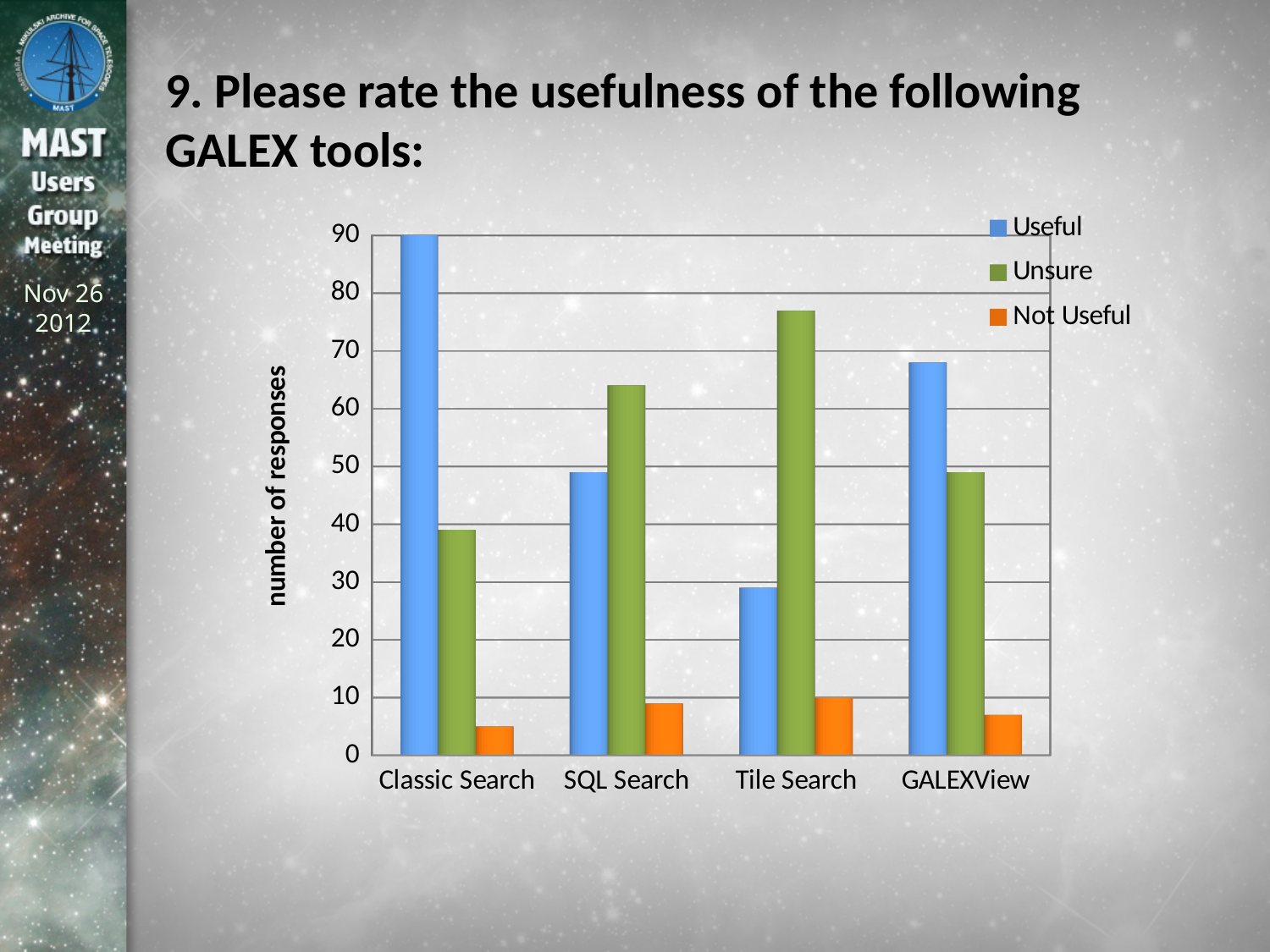
What kind of chart is shown on the slide? bar chart Which tool has the highest number of 'Useful' responses? Classic Search Which tool has the highest number of 'Unsure' responses? Tile Search How many GALEX tools (categories) are shown on the x axis? 4 How many series does the legend list? 3 Which is larger: the 'Useful' value for Classic Search or the 'Useful' value for GALEXView? Classic Search For SQL Search, which is larger: the 'Useful' value or the 'Unsure' value? Unsure Is the 'Useful' value for GALEXView greater or less than 60? greater What is the label on the vertical axis of the chart? number of responses Which tool has the lowest number of 'Useful' responses? Tile Search Which tool has the lowest number of 'Not Useful' responses? Classic Search